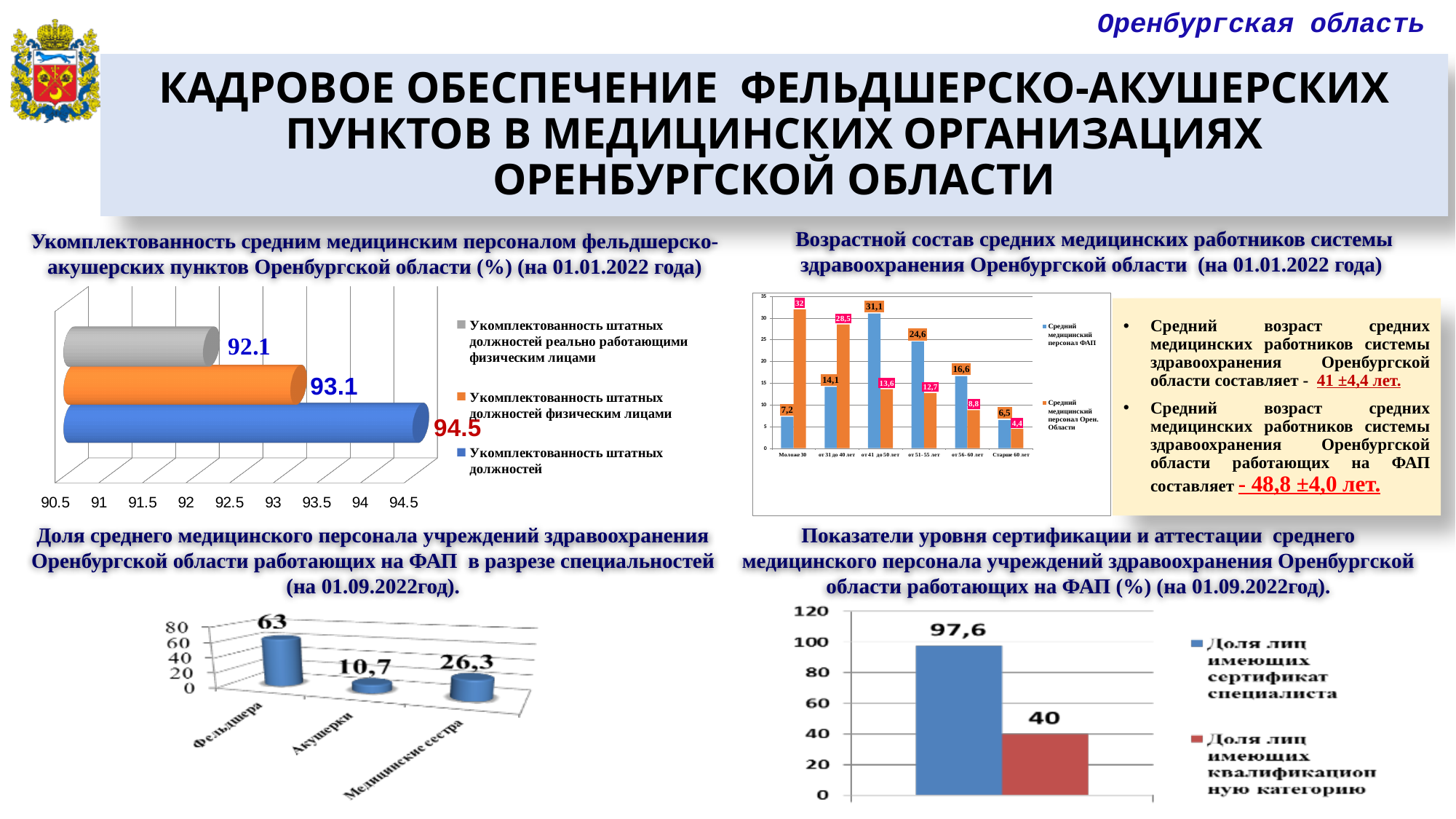
In the top-left chart on staffing of feldsher-midwife stations, which series has the lowest value? Укомплектованность штатных должностей реально работающими физическими лицами What kind of chart is the bottom-right chart on certification and attestation of mid-level medical staff at FAP? bar chart In the top-left chart on staffing of feldsher-midwife stations, what is the difference between 'Укомплектованность штатных должностей' and 'Укомплектованность штатных должностей физическим лицами'? 1.4 In the top-right chart on age composition of mid-level medical workers, how many age groups are shown on the x axis? 6 In the top-right chart on age composition of mid-level medical workers, how many series does the legend list? 2 In the top-right chart on age composition of mid-level medical workers, which series has the larger value in the 'от 51-55 лет' group? Средний медицинский персонал ФАП In the top-right chart on age composition of mid-level medical workers, what is the value for 'Средний медицинский персонал Орен. Области' in the 'Моложе 30' group? 32 In the top-left chart on staffing of feldsher-midwife stations, what is the value for 'Укомплектованность штатных должностей'? 94.5 In the bottom-right chart on certification and attestation of mid-level medical staff at FAP, what is the value for 'Доля лиц имеющих сертификат специалиста'? 97,6 In the bottom-left chart on the share of mid-level medical staff at FAP by specialty, what is the value for 'Акушерки'? 10,7 In the top-right chart on age composition of mid-level medical workers, what is the value for 'Средний медицинский персонал ФАП' in the 'от 41 до 50 лет' group? 31,1 In the bottom-left chart on the share of mid-level medical staff at FAP by specialty, which category has the highest value? Фельдшера